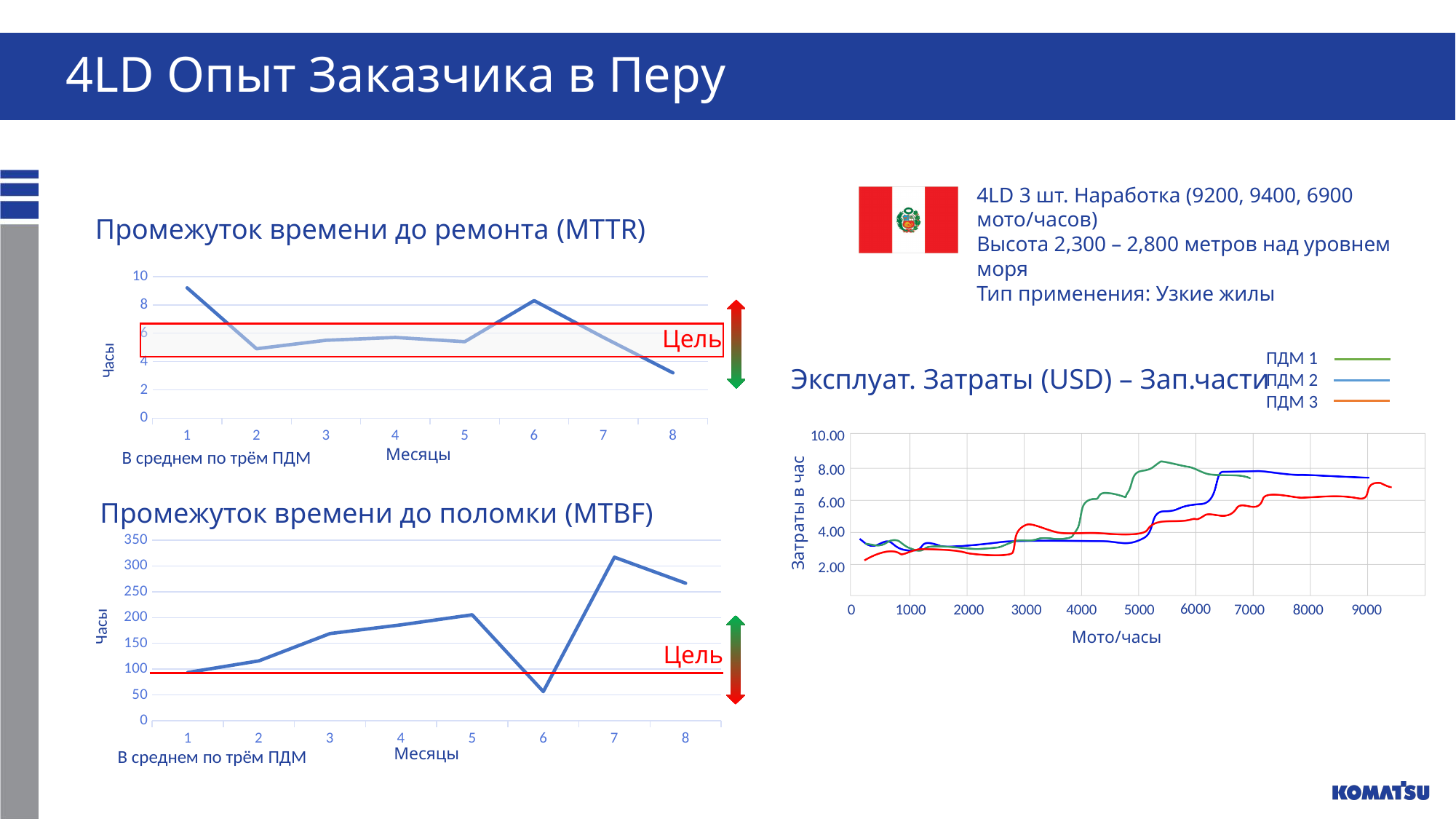
In the 'Промежуток времени до ремонта (MTTR)' chart, how many months are plotted on the x axis? 8 What is the x-axis label of the 'Эксплуат. Затраты (USD) – Зап.части' chart? Мото/часы In the 'Промежуток времени до поломки (MTBF)' chart, which month has the highest value? 7 In the 'Промежуток времени до поломки (MTBF)' chart, is the value for month 3 larger than the value for month 6? yes What kind of chart is the 'Промежуток времени до ремонта (MTTR)' chart? line chart In the 'Промежуток времени до ремонта (MTTR)' chart, which month has the lowest value? 8 In the 'Промежуток времени до ремонта (MTTR)' chart, is the value for month 8 greater or less than 4? less In the 'Промежуток времени до поломки (MTBF)' chart, which month has the lowest value? 6 In the 'Промежуток времени до ремонта (MTTR)' chart, is the value for month 1 greater or less than 8? greater In the 'Промежуток времени до поломки (MTBF)' chart, is the value for month 7 greater or less than 300? greater How many series does the legend of the 'Эксплуат. Затраты (USD) – Зап.части' chart list? 3 In the 'Промежуток времени до ремонта (MTTR)' chart, which month has the highest value? 1